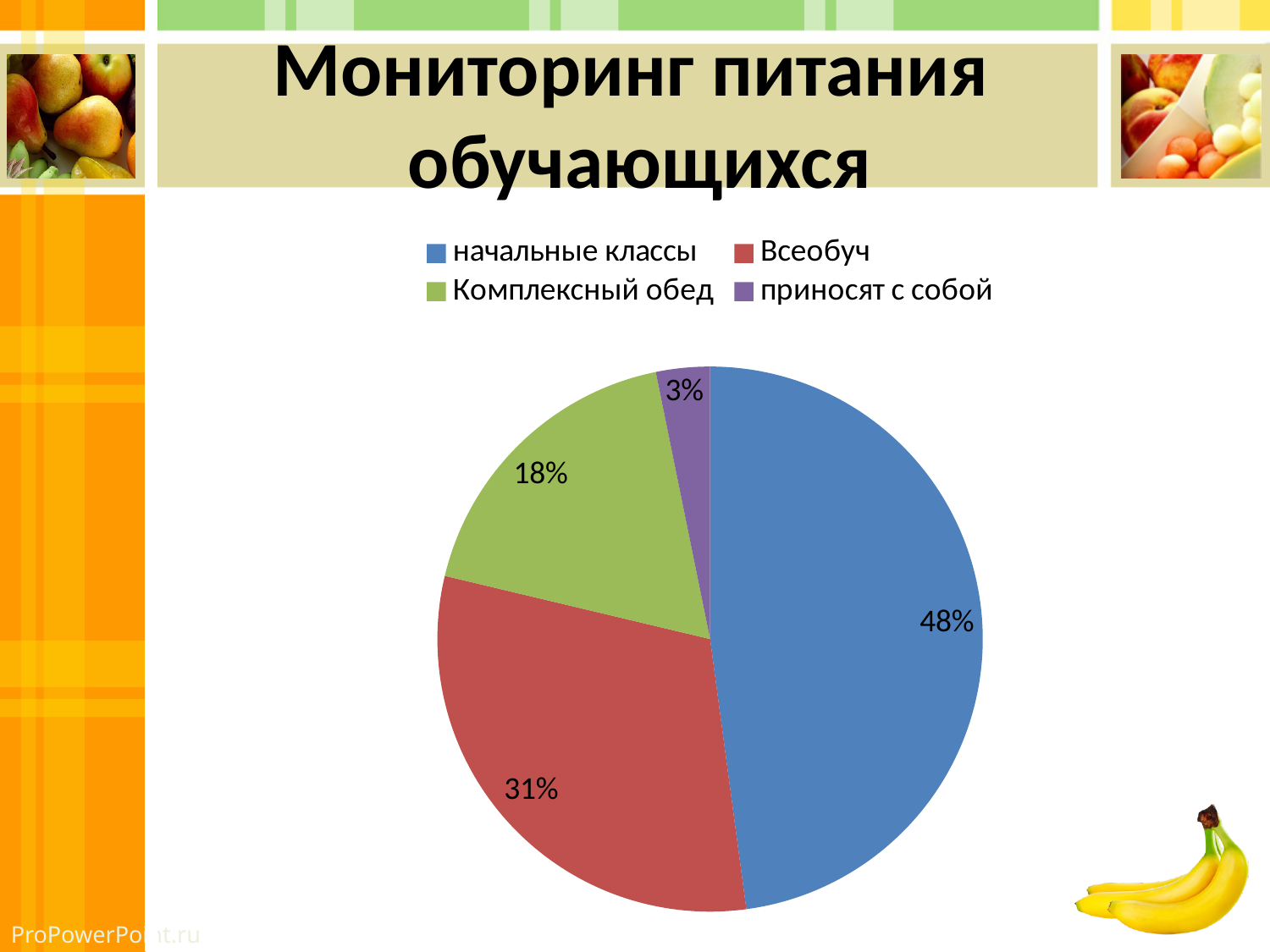
Which category has the largest slice of the pie? начальные классы Which is larger, the slice for Всеобуч or the slice for Комплексный обед? Всеобуч How many slices does the pie chart have? 4 What percentage does the slice for Всеобуч show? 31% What colour is the slice for Комплексный обед? green What kind of chart is shown on the slide? pie chart What percentage does the slice for приносят с собой show? 3% Which category has the smallest slice of the pie? приносят с собой What is the difference in percentage points between начальные классы and Всеобуч? 17 How many entries does the legend list? 4 What percentage does the slice for Комплексный обед show? 18% What percentage does the slice for начальные классы show? 48%